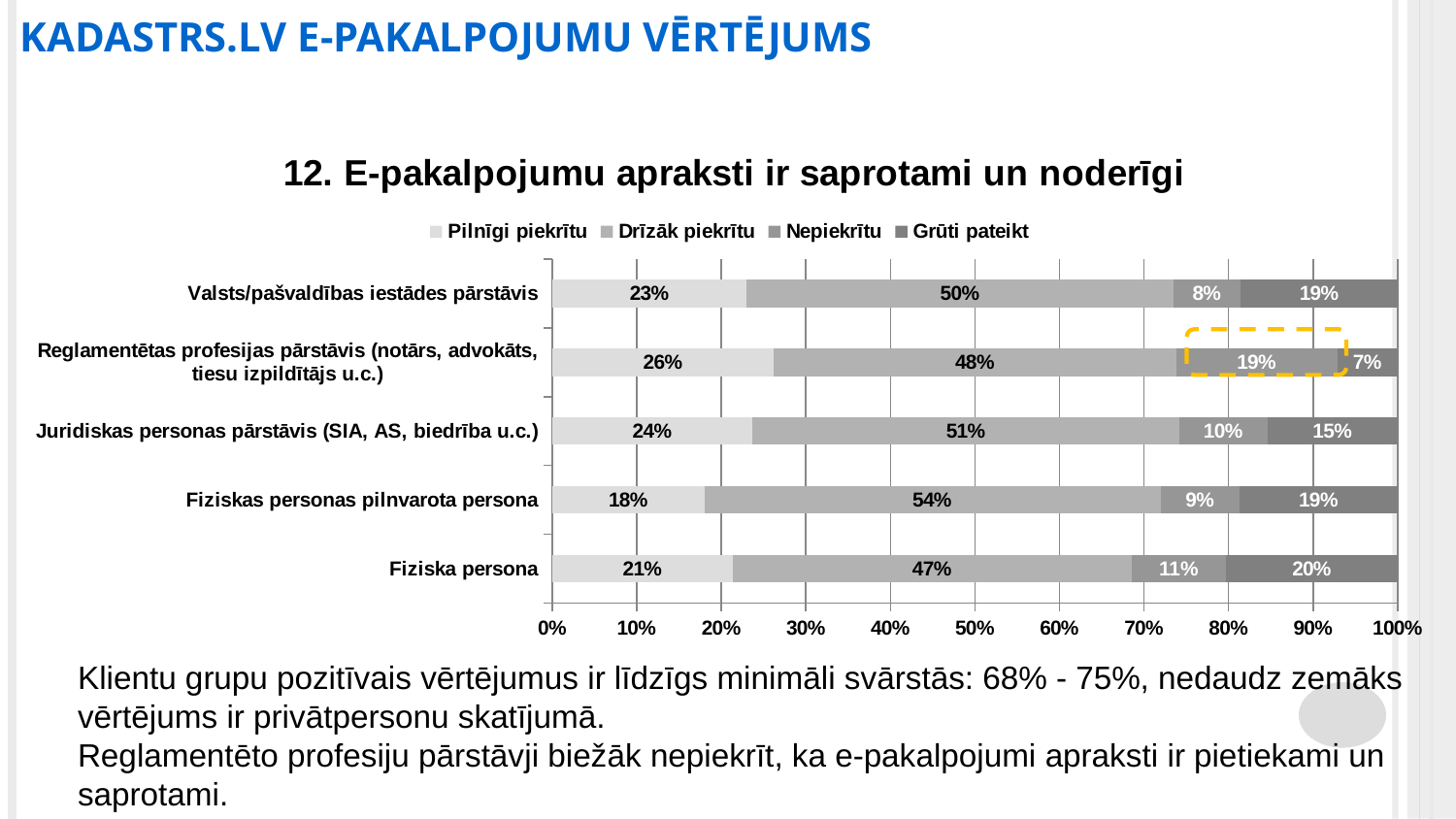
What is the 'Nepiekrītu' value for 'Fiziska persona'? 11% Which category has the lowest 'Pilnīgi piekrītu' value? Fiziskas personas pilnvarota persona How many categories (respondent groups) are shown on the chart? 5 Which category has the highest 'Nepiekrītu' value? Reglamentētas profesijas pārstāvis (notārs, advokāts, tiesu izpildītājs u.c.) What type of chart is shown on the slide? Stacked bar chart How many series does the legend list? 4 What is the 'Pilnīgi piekrītu' value for 'Reglamentētas profesijas pārstāvis (notārs, advokāts, tiesu izpildītājs u.c.)'? 26% What is the 'Drīzāk piekrītu' value for 'Fiziskas personas pilnvarota persona'? 54% What is the combined 'Pilnīgi piekrītu' and 'Drīzāk piekrītu' share for 'Juridiskas personas pārstāvis (SIA, AS, biedrība u.c.)'? 75% Which is larger: the 'Grūti pateikt' value for 'Fiziska persona' or for 'Juridiskas personas pārstāvis (SIA, AS, biedrība u.c.)'? Fiziska persona What is the difference between the 'Drīzāk piekrītu' values for 'Fiziskas personas pilnvarota persona' and 'Fiziska persona'? 7% What is the title of the chart? 12. E-pakalpojumu apraksti ir saprotami un noderīgi